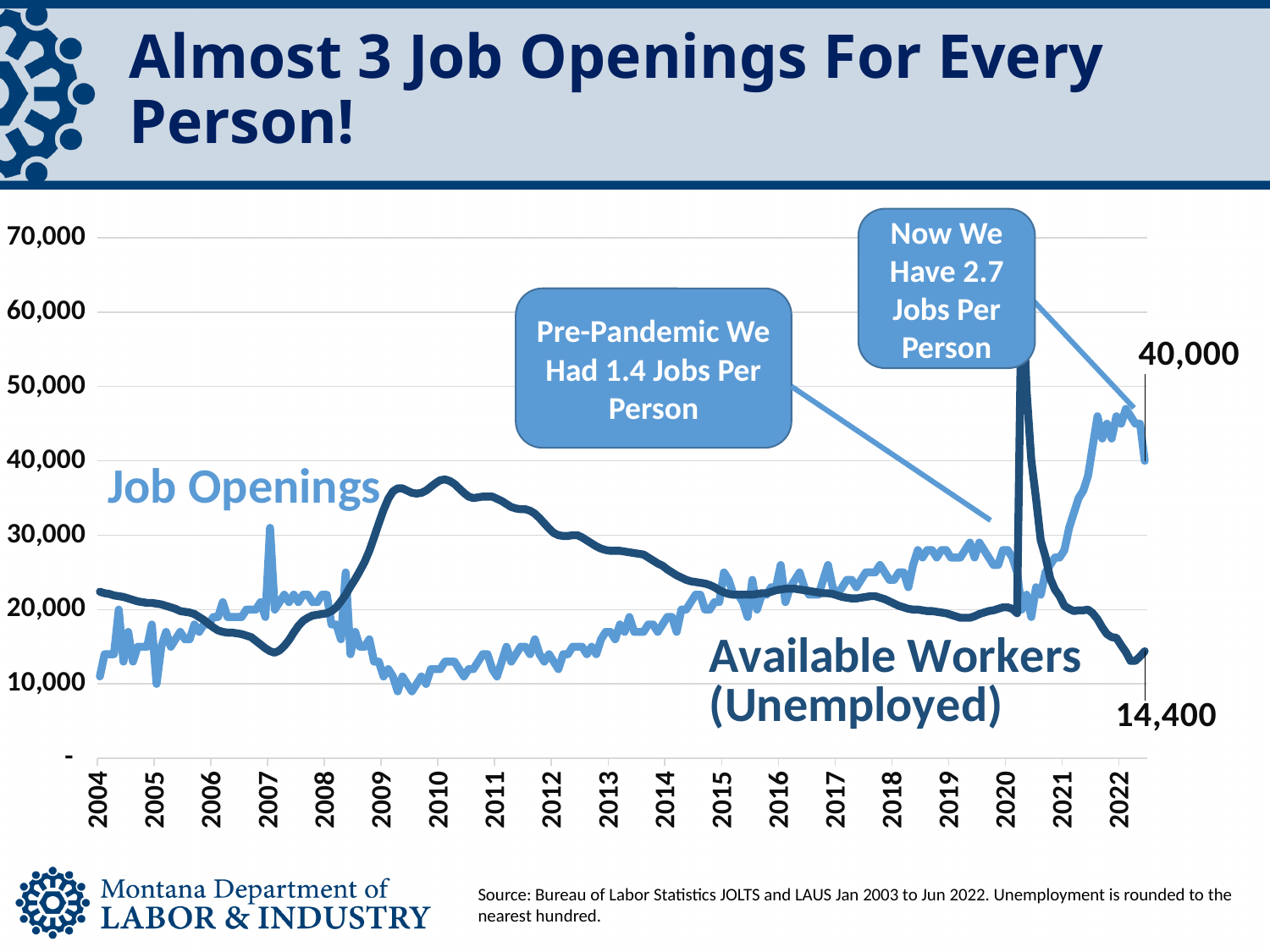
Does the Available Workers (Unemployed) series rise or fall between 2010 and 2019? fall Is the peak of the Available Workers (Unemployed) series around 2010 greater or less than 30,000? greater Which series reaches the highest value anywhere on the chart? Available Workers (Unemployed) At the end of the chart in 2022, which series is higher: Job Openings or Available Workers (Unemployed)? Job Openings What is the difference between the final labelled values of Job Openings (40,000) and Available Workers (14,400)? 25,600 How many data series are plotted on the chart? 2 According to the callout on the chart, how many jobs per person are there now? 2.7 What kind of chart is shown on the slide? line chart What is the labelled final value of the Available Workers (Unemployed) series? 14,400 Around 2010, which series is higher: Job Openings or Available Workers (Unemployed)? Available Workers (Unemployed) Is the value of Job Openings in 2009 greater or less than 20,000? less What is the labelled final value of the Job Openings series? 40,000